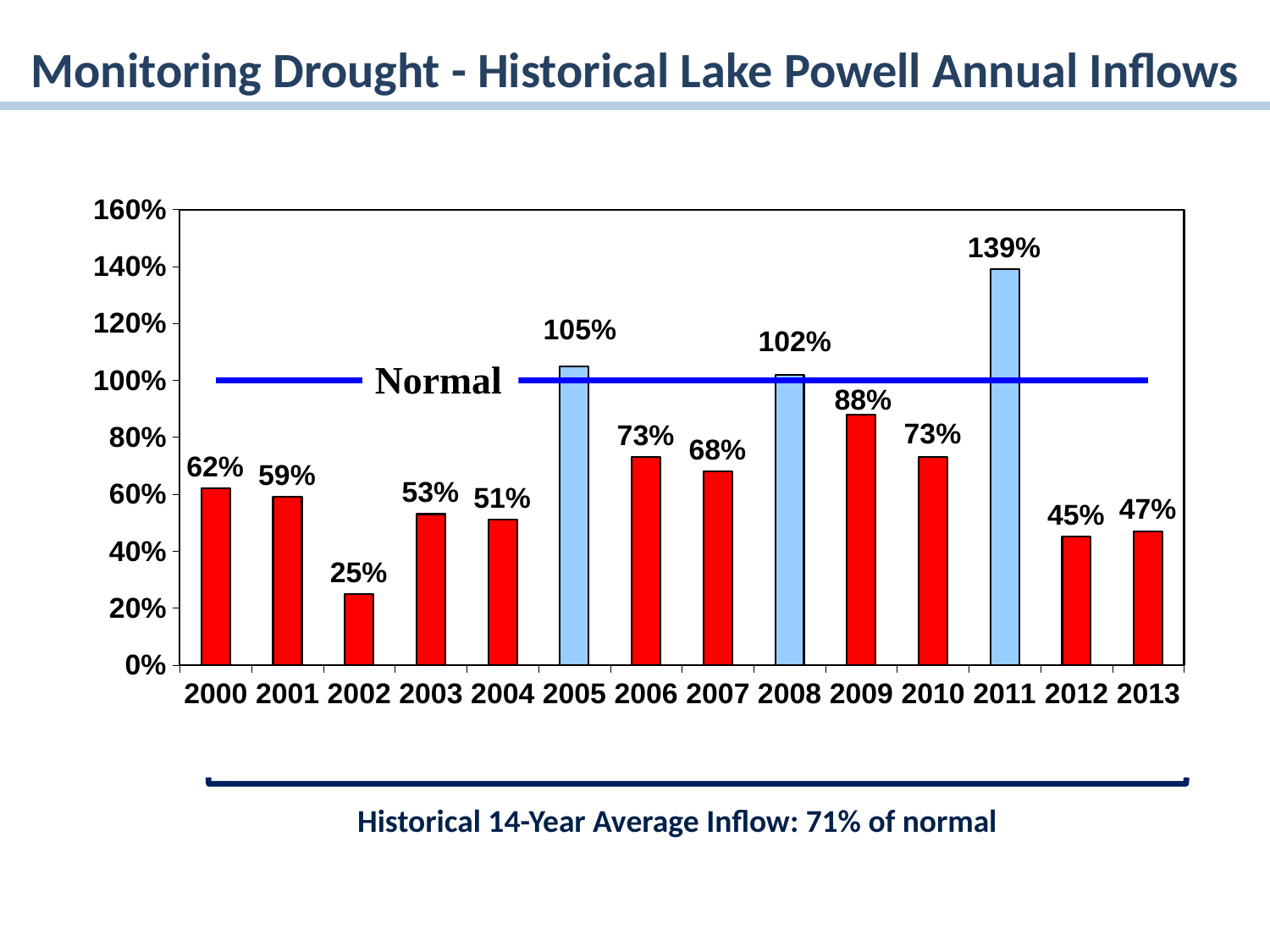
Which year has a larger inflow, 2000 or 2012? 2000 What is the inflow value for 2011? 139% How many years are shown on the x axis? 14 What kind of chart is shown on the slide? bar chart What is the inflow value for 2009? 88% What is the difference between the inflow values for 2005 and 2008? 3% Which year has the highest inflow? 2011 Do the inflow values rise or fall from 2009 to 2010? fall What is the inflow value for 2002? 25% What is the difference between the inflow values for 2011 and 2002? 114% What does the horizontal blue line across the chart represent? Normal Which year has the lowest inflow? 2002